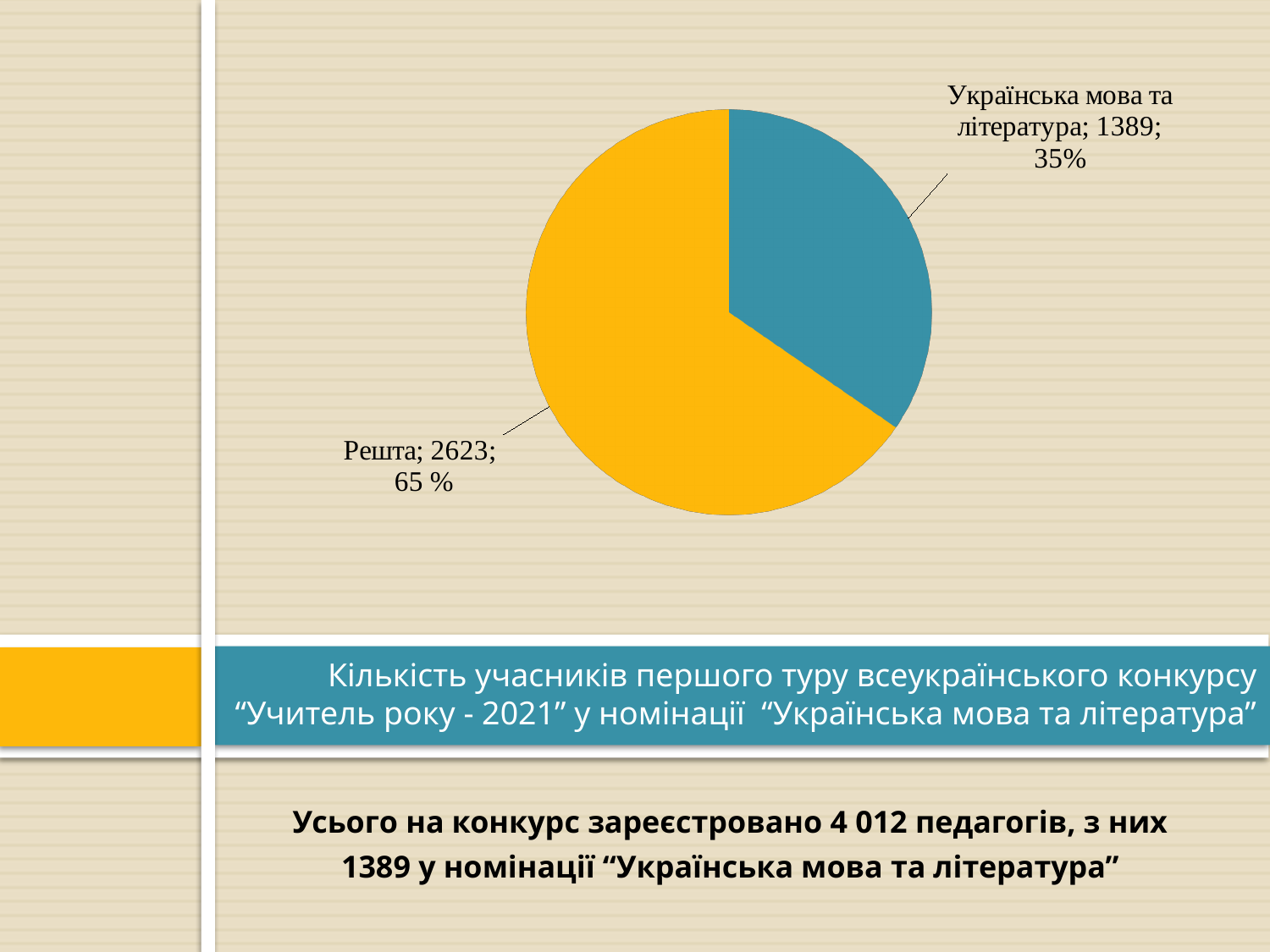
What share of the pie does "Українська мова та література" represent? 35% What is the value for "Українська мова та література" in the pie chart? 1389 How many slices does the pie chart have? 2 What is the value for "Решта" in the pie chart? 2623 What is the total of the two slices in the pie chart? 4012 What colour is the slice for "Українська мова та література"? teal blue Which slice of the pie chart is the smallest? Українська мова та література What kind of chart is shown on the slide? pie chart What is the difference between the values for "Решта" and "Українська мова та література"? 1234 Which slice of the pie chart is the largest? Решта What share of the pie does "Решта" represent? 65 % Which is larger: the value for "Решта" or the value for "Українська мова та література"? Решта